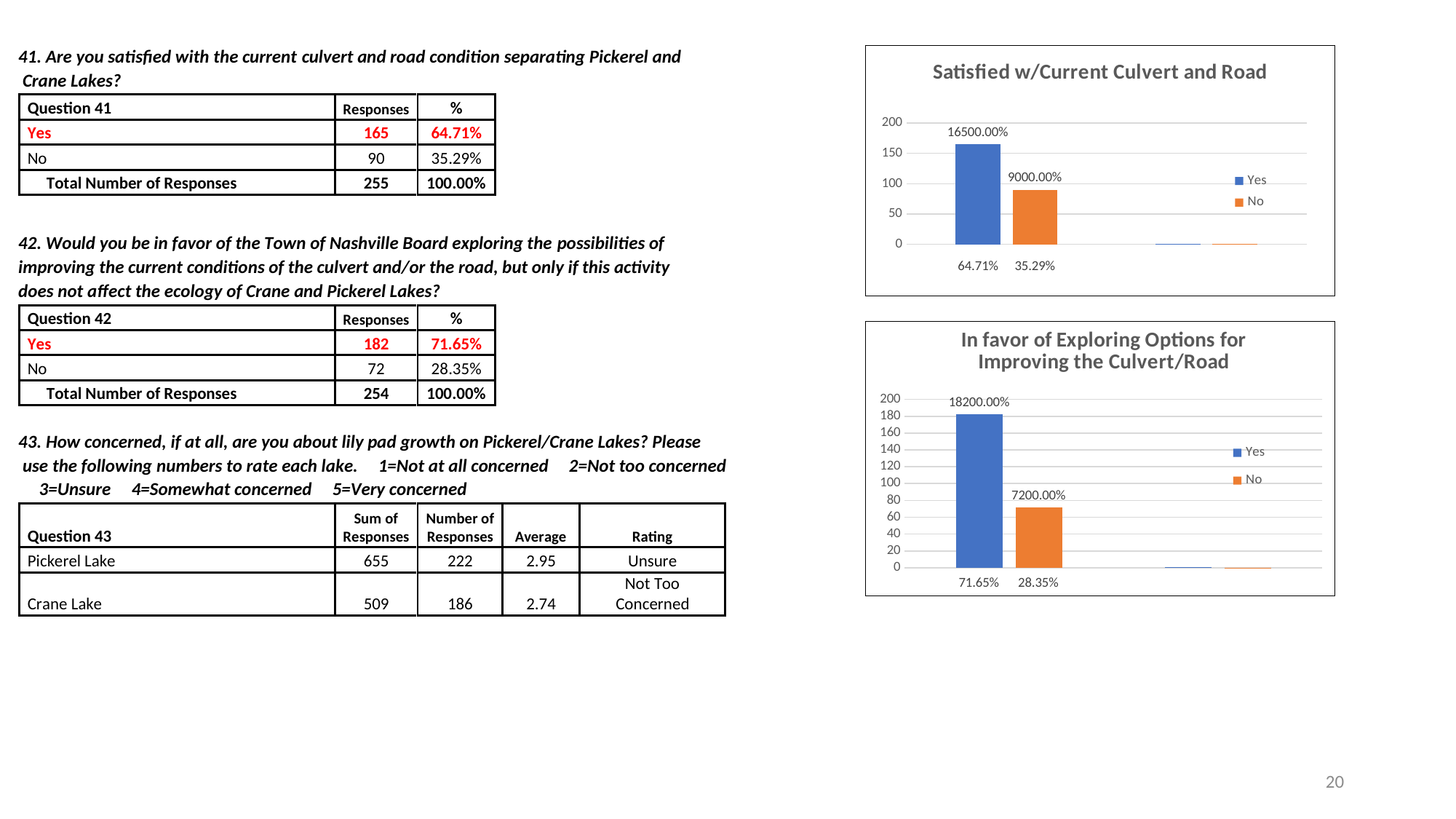
In the chart titled "In favor of Exploring Options for Improving the Culvert/Road", what data label is printed above the Yes bar? 18200.00% In the chart titled "In favor of Exploring Options for Improving the Culvert/Road", what data label is printed above the No bar? 7200.00% In the chart titled "Satisfied w/Current Culvert and Road", is the value for the Yes bar greater or less than 150? greater In the chart titled "Satisfied w/Current Culvert and Road", is the value for the No bar greater or less than 100? less In the chart titled "In favor of Exploring Options for Improving the Culvert/Road", is the value for the No bar greater or less than 100? less In the chart titled "Satisfied w/Current Culvert and Road", what data label is printed above the No bar? 9000.00% What kind of chart is the lower chart on the right side of the slide? Bar chart In the chart titled "In favor of Exploring Options for Improving the Culvert/Road", which bar is the tallest? Yes In the chart titled "Satisfied w/Current Culvert and Road", what data label is printed above the Yes bar? 16500.00% In the chart titled "Satisfied w/Current Culvert and Road", which bar is taller, Yes or No? Yes In the chart titled "Satisfied w/Current Culvert and Road", how many series does the legend list? 2